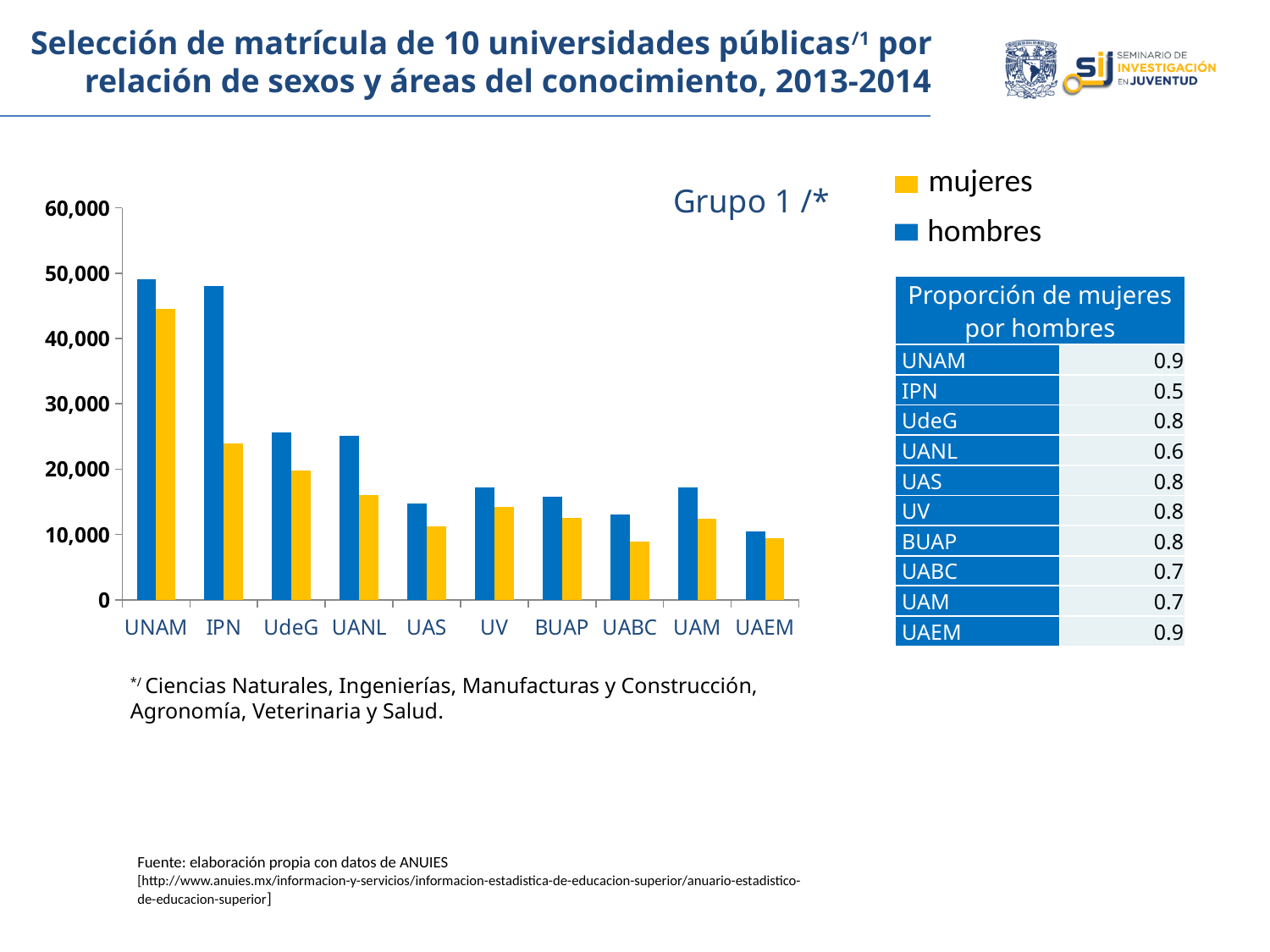
Which is larger, the value for hombres at UAM or the value for hombres at UAS? UAM Is the value for mujeres at UNAM greater or less than 40,000? greater Which university has the lowest value for hombres? UAEM What kind of chart is shown on the slide? bar chart Is the value for mujeres at UABC greater or less than 10,000? less How many universities are shown on the x axis of the chart? 10 Is the value for hombres at UdeG greater or less than 20,000? greater At IPN, which is larger, the value for hombres or the value for mujeres? hombres Which university has the highest value for mujeres? UNAM Which colour represents the mujeres series in the chart? yellow How many series does the chart's legend list? 2